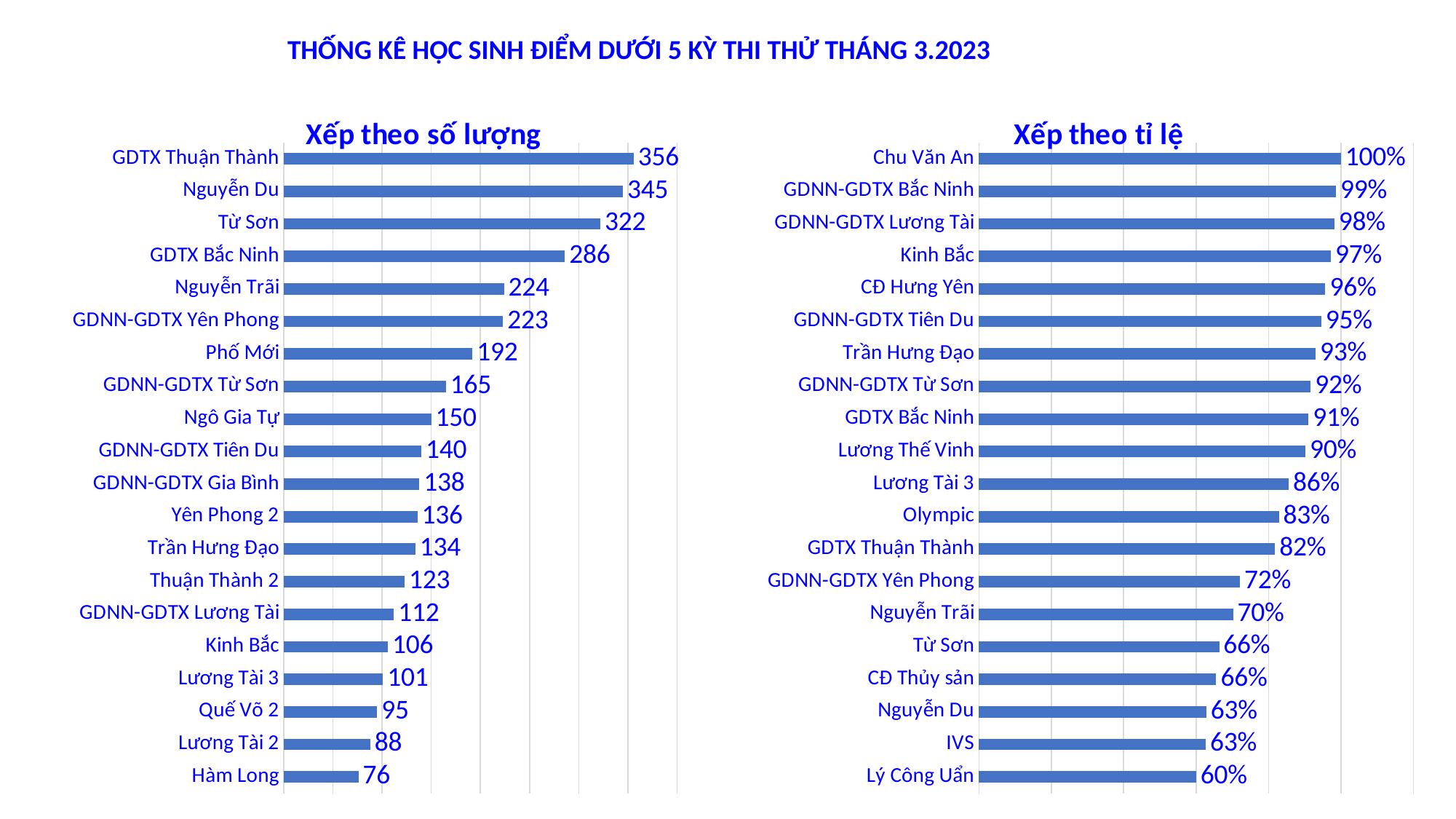
How many categories are shown in the 'Xếp theo tỉ lệ' chart? 20 In the 'Xếp theo số lượng' chart, what is the value for Phố Mới? 192 In the 'Xếp theo tỉ lệ' chart, what is the difference between Chu Văn An and Olympic? 17% How many categories are shown in the 'Xếp theo số lượng' chart? 20 In the 'Xếp theo tỉ lệ' chart, which category has the lowest value? Lý Công Uẩn In the 'Xếp theo số lượng' chart, which category has the highest value? GDTX Thuận Thành What is the title of the chart on the left side of the slide? Xếp theo số lượng In the 'Xếp theo tỉ lệ' chart, which is larger: Kinh Bắc or Nguyễn Du? Kinh Bắc What type of chart is the 'Xếp theo tỉ lệ' chart? Bar chart In the 'Xếp theo số lượng' chart, what is the difference between GDTX Thuận Thành and Hàm Long? 280 In the 'Xếp theo số lượng' chart, which is larger: Nguyễn Trãi or Ngô Gia Tự? Nguyễn Trãi In the 'Xếp theo tỉ lệ' chart, what is the value for Lương Thế Vinh? 90%